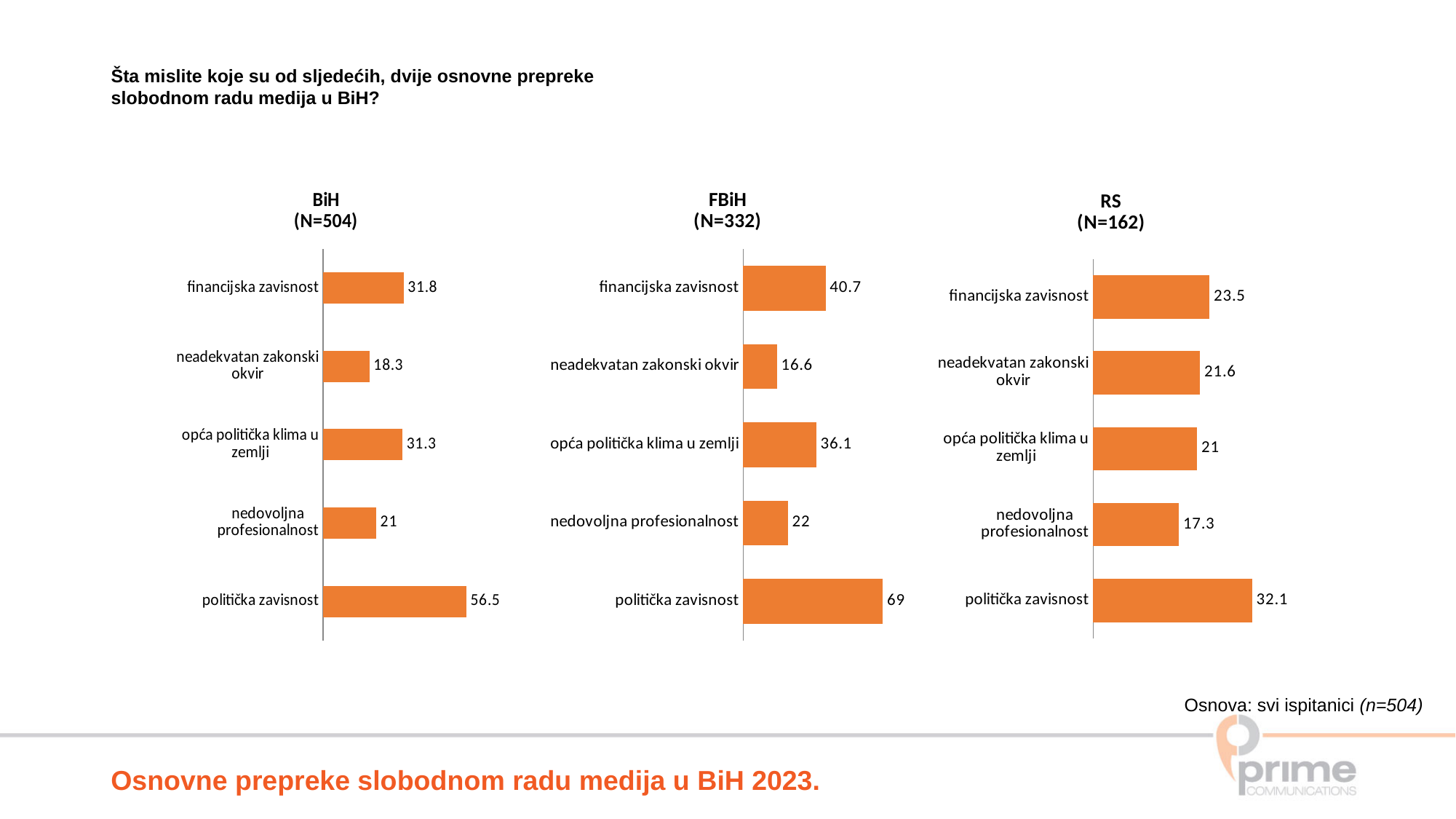
In the BiH (N=504) chart, which is larger: financijska zavisnost or nedovoljna profesionalnost? financijska zavisnost In the BiH (N=504) chart, what is the value for politička zavisnost? 56.5 In the FBiH (N=332) chart, what is the value for financijska zavisnost? 40.7 In the FBiH (N=332) chart, which category has the highest value? politička zavisnost In the RS (N=162) chart, what is the difference between politička zavisnost and financijska zavisnost? 8.6 What type of chart is the RS (N=162) chart? bar chart In the FBiH (N=332) chart, what is the difference between politička zavisnost and financijska zavisnost? 28.3 In the RS (N=162) chart, which category has the lowest value? nedovoljna profesionalnost In the BiH (N=504) chart, which category has the lowest value? neadekvatan zakonski okvir How many categories are shown in the FBiH (N=332) chart? 5 How many charts are shown on the slide? 3 In the RS (N=162) chart, what is the value for nedovoljna profesionalnost? 17.3